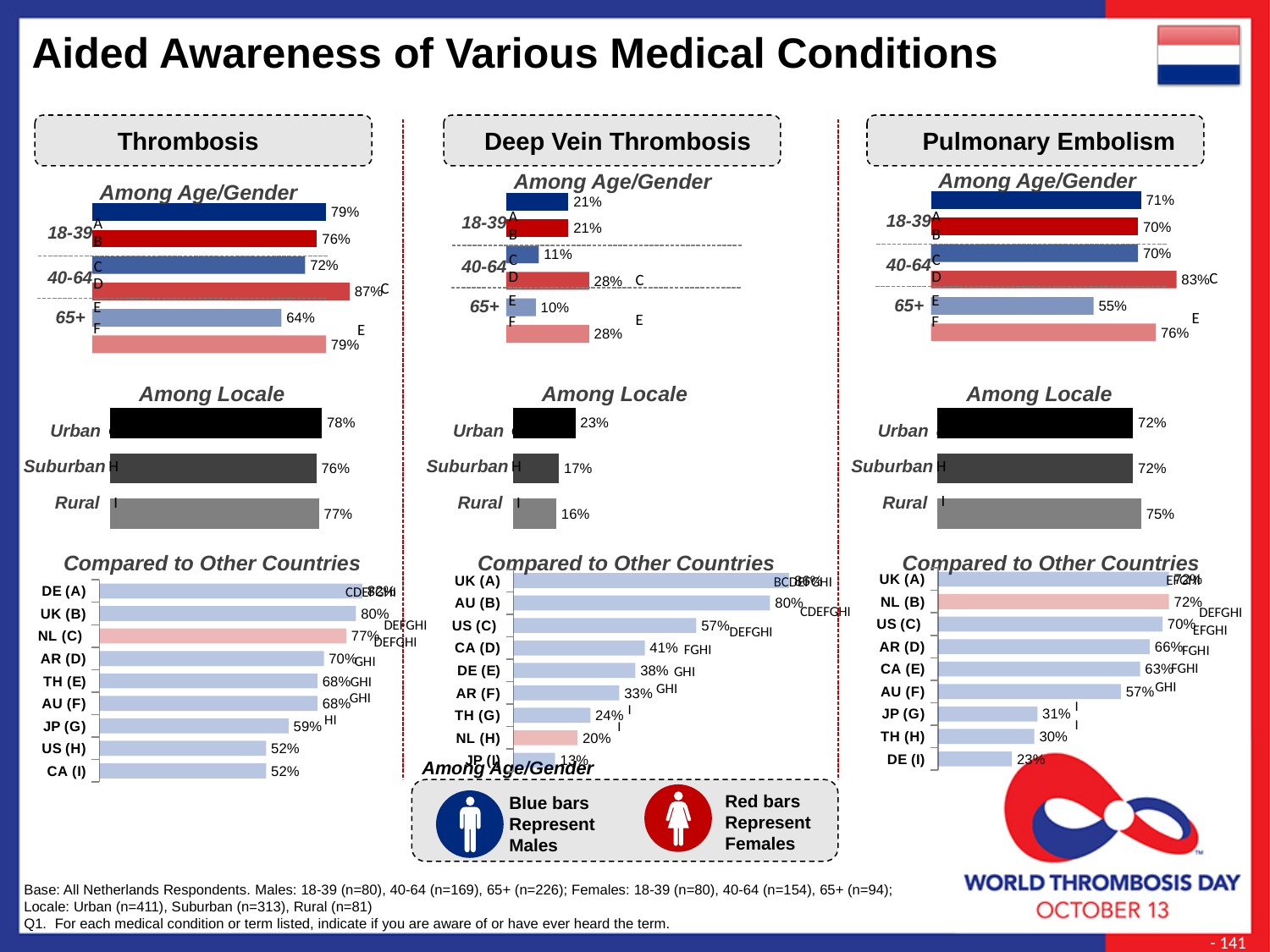
In the Deep Vein Thrombosis 'Among Locale' chart, what is the difference between Urban and Rural? 7% In the Deep Vein Thrombosis 'Compared to Other Countries' chart, what is the value for AU (B)? 80% In the Deep Vein Thrombosis 'Compared to Other Countries' chart, which is larger, US (C) or CA (D)? US (C) In the Pulmonary Embolism 'Compared to Other Countries' chart, what is the value for DE (I)? 23% In the Thrombosis 'Among Age/Gender' chart, which bar has the lowest value? E (males 65+), 64% In the Pulmonary Embolism 'Among Age/Gender' chart, what is the value for females aged 40-64 (bar D)? 83% In the Thrombosis 'Among Age/Gender' chart, what is the value for females aged 40-64 (bar D)? 87% How many countries are listed in the Thrombosis 'Compared to Other Countries' chart? 9 In the Deep Vein Thrombosis 'Among Age/Gender' chart, what is the value for males aged 65+ (bar E)? 10% In the Thrombosis 'Among Locale' chart, what is the value for Urban? 78% In the Pulmonary Embolism 'Among Locale' chart, which locale has the highest value? Rural, 75% According to the legend at the bottom of the slide, what do the red bars represent? Females